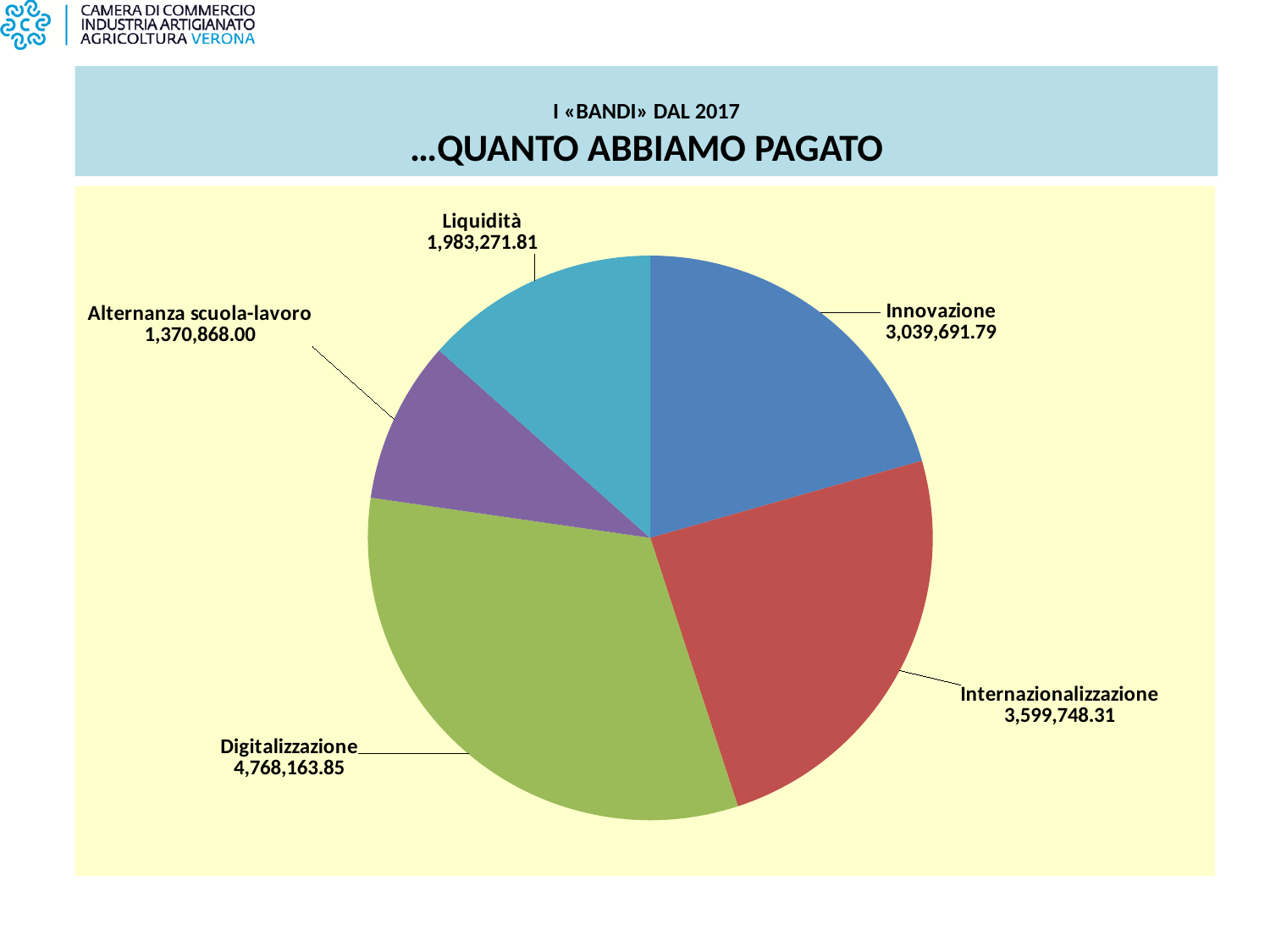
What is the value for Innovazione? 3,039,691.79 What is the difference between Liquidità and Alternanza scuola-lavoro? 612,403.81 What is the value for Liquidità? 1,983,271.81 What is the value for Alternanza scuola-lavoro? 1,370,868.00 What is the main title of the chart on the slide? ...QUANTO ABBIAMO PAGATO Which category has the smallest value? Alternanza scuola-lavoro What is the value for Digitalizzazione? 4,768,163.85 Which is larger, Internazionalizzazione or Innovazione? Internazionalizzazione What is the difference between Digitalizzazione and Internazionalizzazione? 1,168,415.54 Which category has the largest value? Digitalizzazione What kind of chart is shown on the slide? Pie chart How many slices does the pie chart have? 5